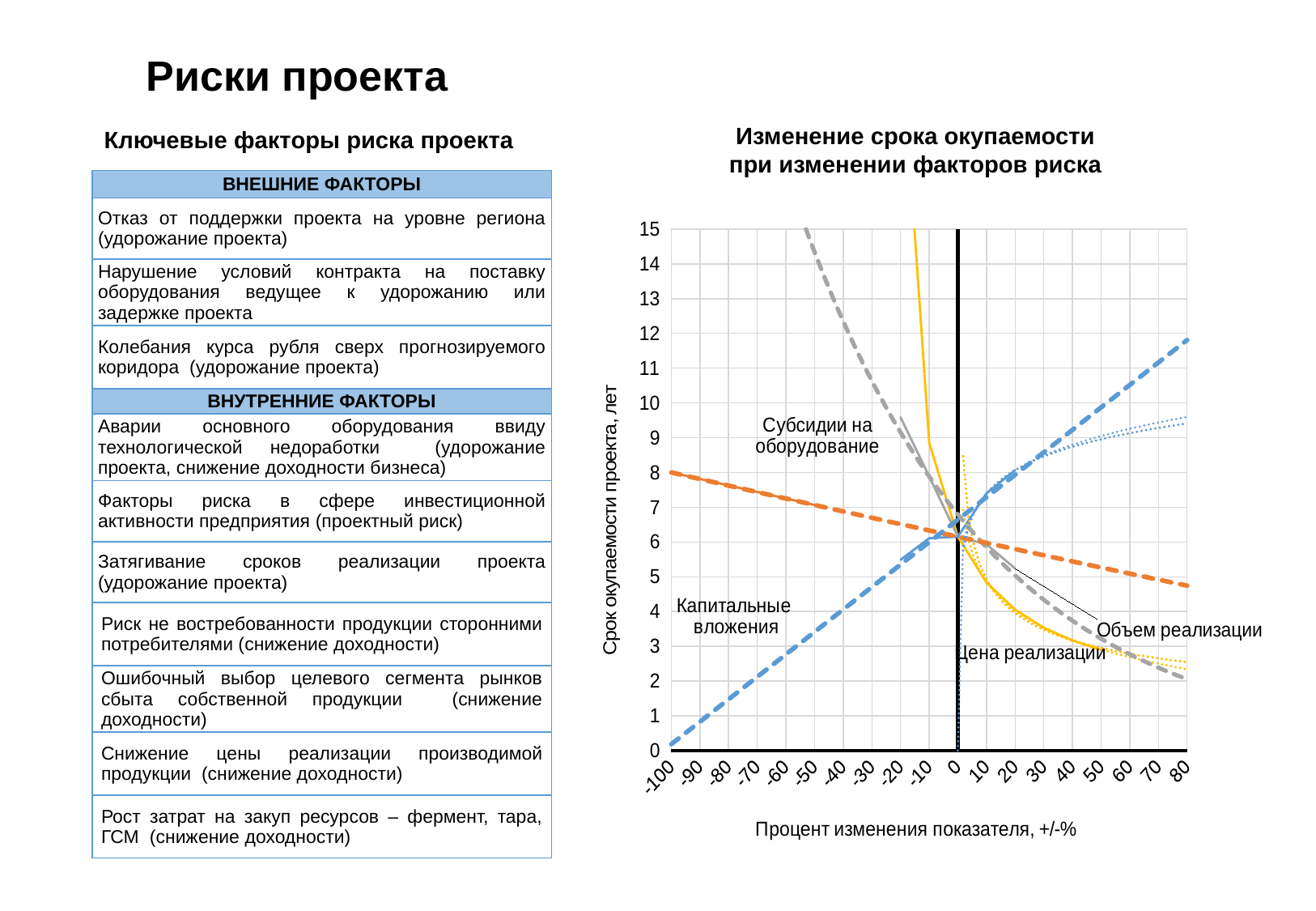
What is the title of the chart on the slide? Изменение срока окупаемости при изменении факторов риска Does the line for Субсидии на оборудование rise or fall as the percent change increases along the x axis? falls Does the line for Капитальные вложения rise or fall as the percent change increases from -100 to 80? rises What is the label of the vertical axis of the chart? Срок окупаемости проекта, лет Is the value for Субсидии на оборудование at 80% greater or less than 3? greater At -100% change, which is larger: the value for Капитальные вложения or the value for Субсидии на оборудование? Субсидии на оборудование At 80% change, which is larger: the value for Капитальные вложения or the value for Субсидии на оборудование? Капитальные вложения What is the highest value shown on the vertical axis of the chart? 15 What kind of chart is shown on the slide? line chart Is the value for Субсидии на оборудование at -50% greater or less than 12? less Is the value for Капитальные вложения at -100% greater or less than 1? less